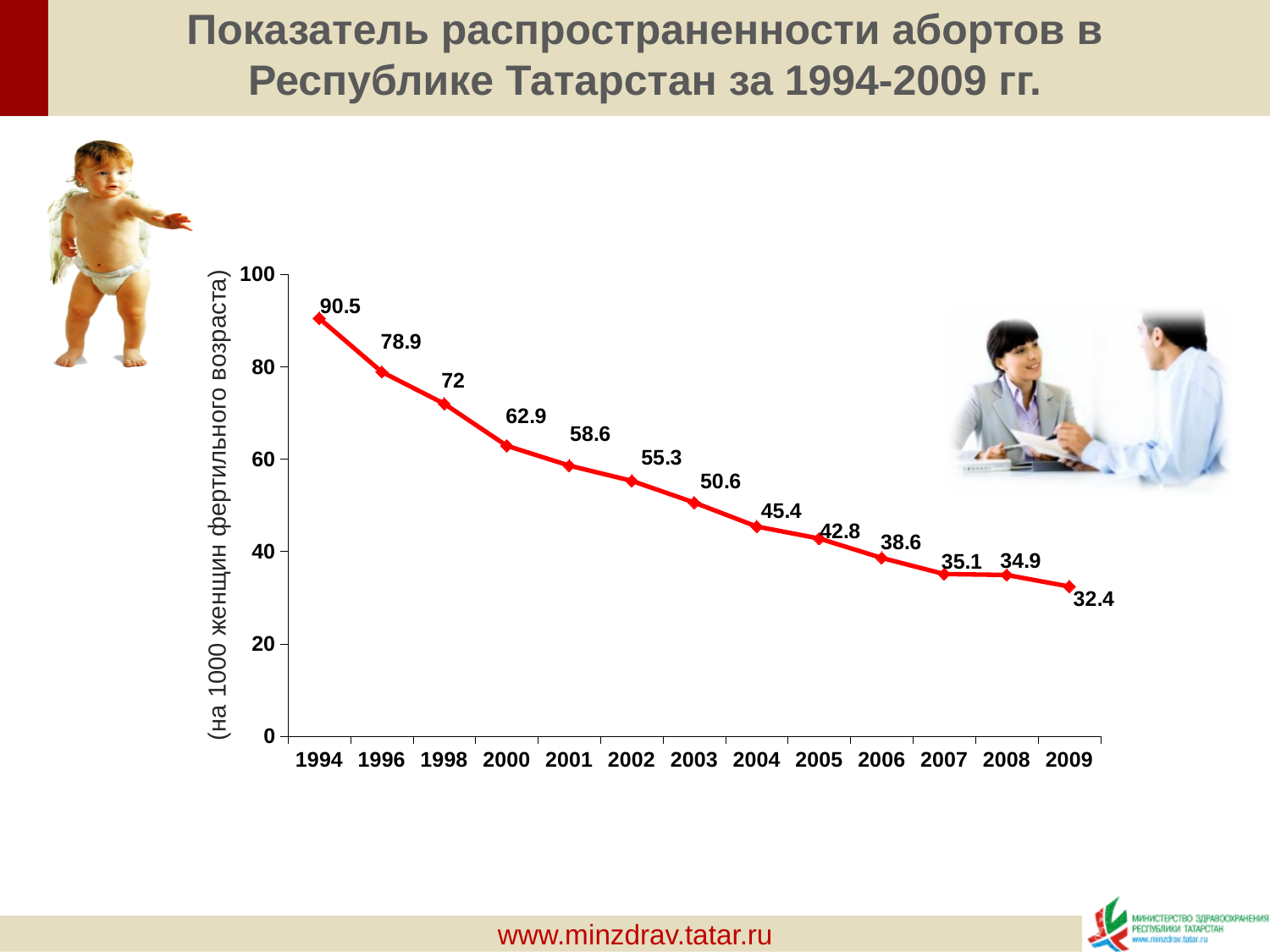
Which is larger, the value for 1998 or the value for 2002? 1998 What is the value plotted for 2003? 50.6 What kind of chart is shown on the slide? line chart How many years are plotted on the x axis? 13 Do the values rise or fall from 1994 to 2009? fall What is the abortion rate value for 1994? 90.5 What is the difference between the values for 1994 and 2009? 58.1 What is the difference between the values for 2000 and 2001? 4.3 Which year has the lowest value on the chart? 2009 What is the value plotted for 2009? 32.4 Which year has the highest value on the chart? 1994 Is the value for 2006 greater or less than 40? less